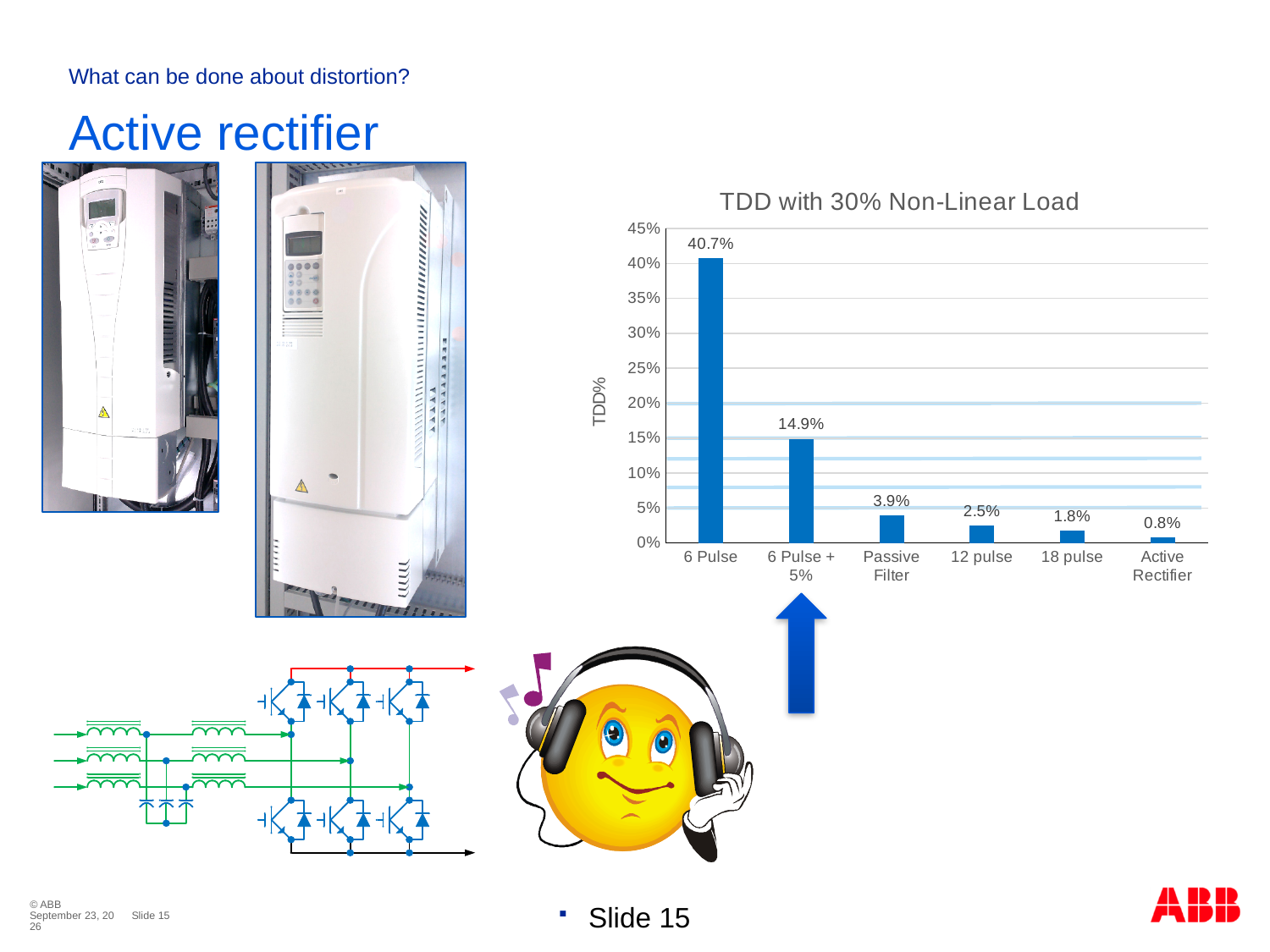
Which has a larger TDD value, 12 pulse or 18 pulse? 12 pulse Which category has the highest TDD value? 6 Pulse What is the TDD value for 6 Pulse? 40.7% What kind of chart is shown on the slide? bar chart What is the title of the chart? TDD with 30% Non-Linear Load Which category has the lowest TDD value? Active Rectifier What is the difference between the TDD values for 6 Pulse and 6 Pulse + 5%? 25.8% Is the TDD value for 6 Pulse + 5% greater or less than 10%? greater How many categories are shown on the x axis of the chart? 6 What is the TDD value for the Passive Filter? 3.9% What is the TDD value for the Active Rectifier? 0.8% What is the TDD value for 18 pulse? 1.8%